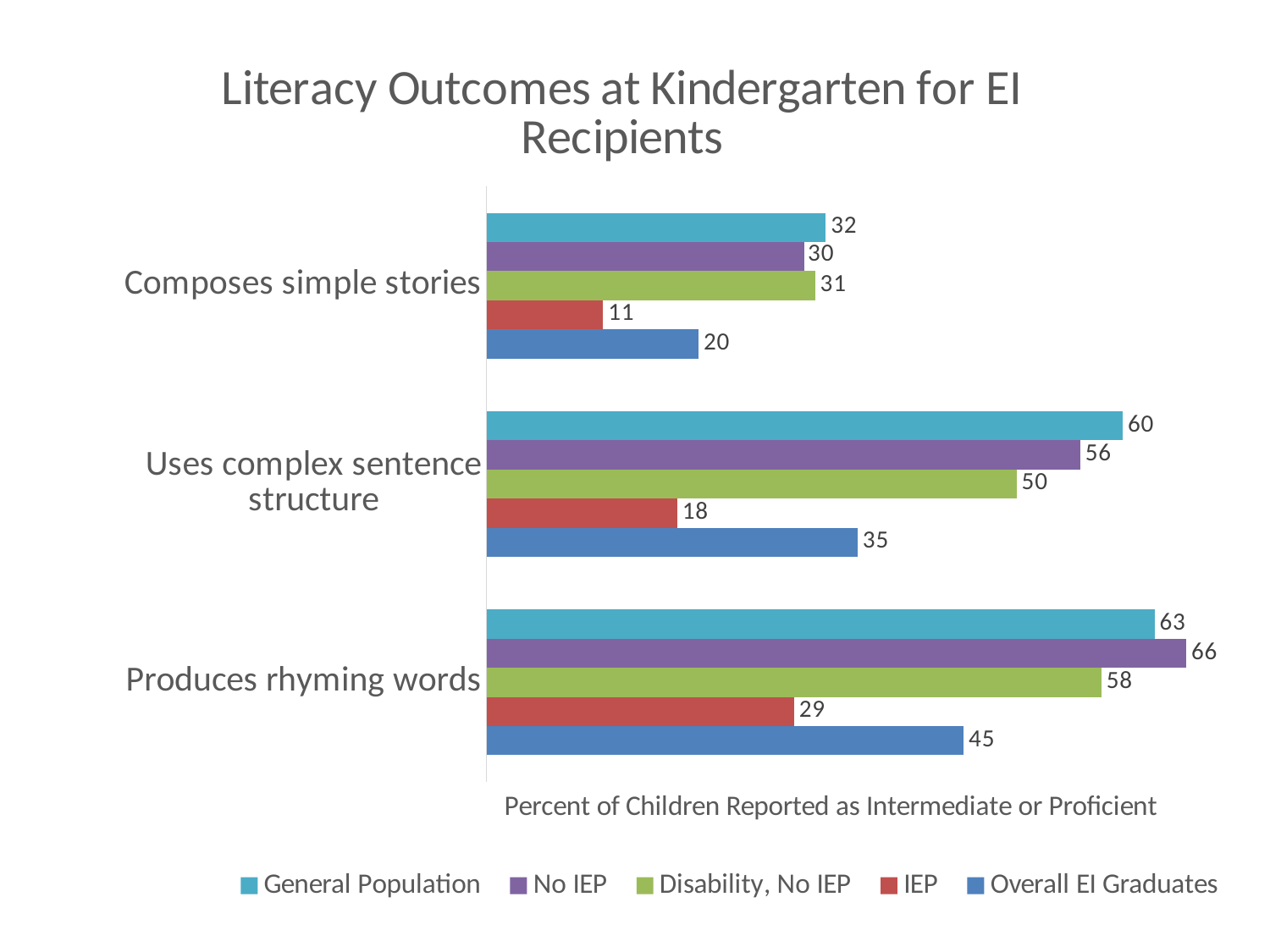
Which series has the lowest value for Uses complex sentence structure? IEP Which is larger for Composes simple stories: the No IEP value or the Overall EI Graduates value? No IEP What is the difference between the General Population and IEP values for Uses complex sentence structure? 42 What kind of chart is shown on the slide? Bar chart What is the value for IEP on Composes simple stories? 11 How many series does the legend list? 5 How many categories are shown on the chart? 3 Which series has the highest value for Produces rhyming words? No IEP What is the title of the chart? Literacy Outcomes at Kindergarten for EI Recipients What is the value for General Population on Produces rhyming words? 63 What is the value for Overall EI Graduates on Uses complex sentence structure? 35 What is the value for Disability, No IEP on Uses complex sentence structure? 50